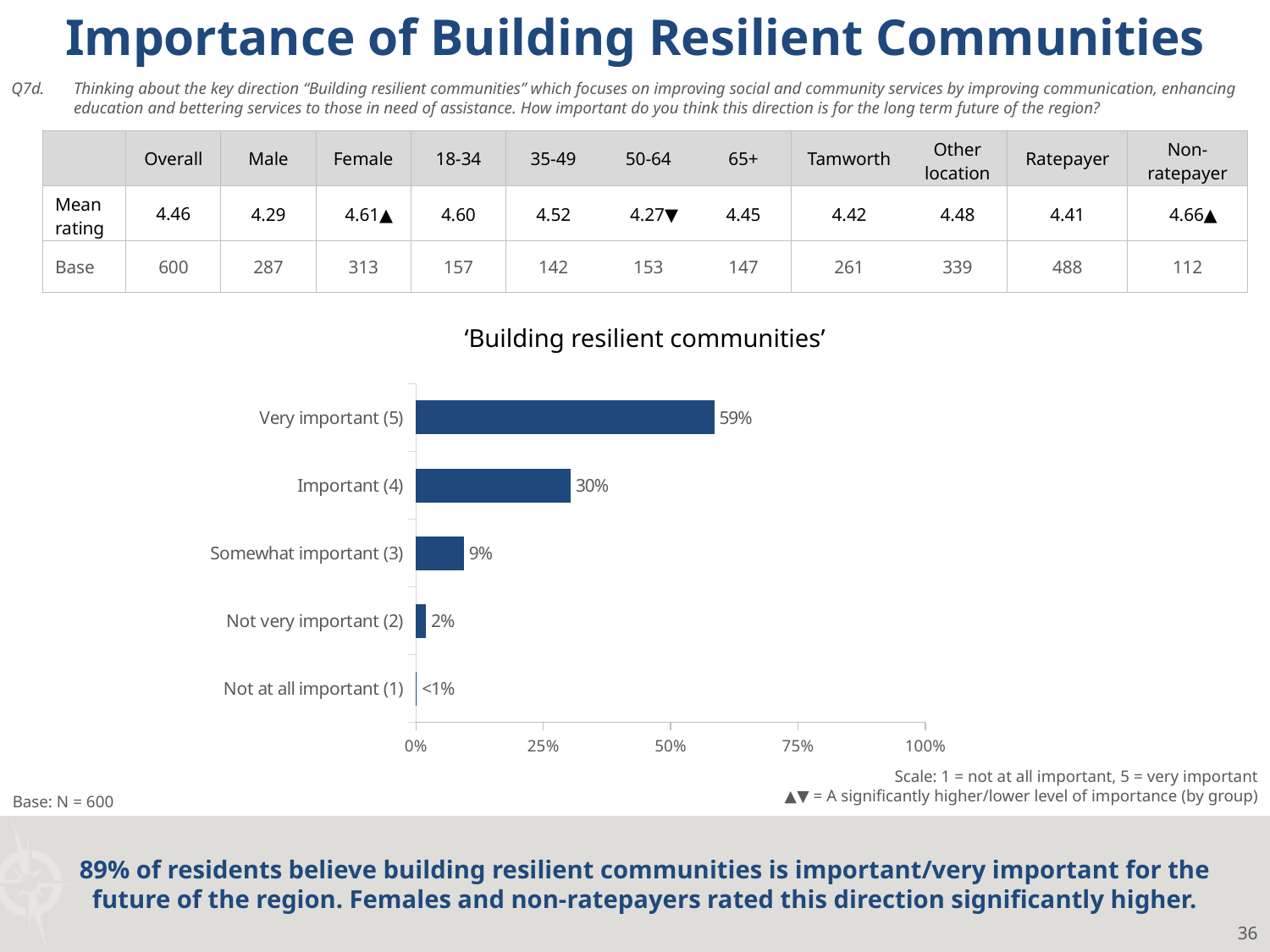
What is the difference between the 'Very important (5)' and 'Important (4)' values? 29% What is the value shown for 'Not at all important (1)'? <1% How many categories are shown in the chart? 5 What type of chart is shown on the slide? Bar chart Which category has the lowest value in the chart? Not at all important (1) What is the value shown for 'Somewhat important (3)'? 9% What is the title of the chart? 'Building resilient communities' What percentage of respondents rated building resilient communities as 'Very important (5)'? 59% What is the value shown for 'Important (4)'? 30% Which category has the highest value in the chart? Very important (5) Which is larger: the value for 'Somewhat important (3)' or 'Not very important (2)'? Somewhat important (3) Is the value for 'Very important (5)' greater or less than 50%? greater